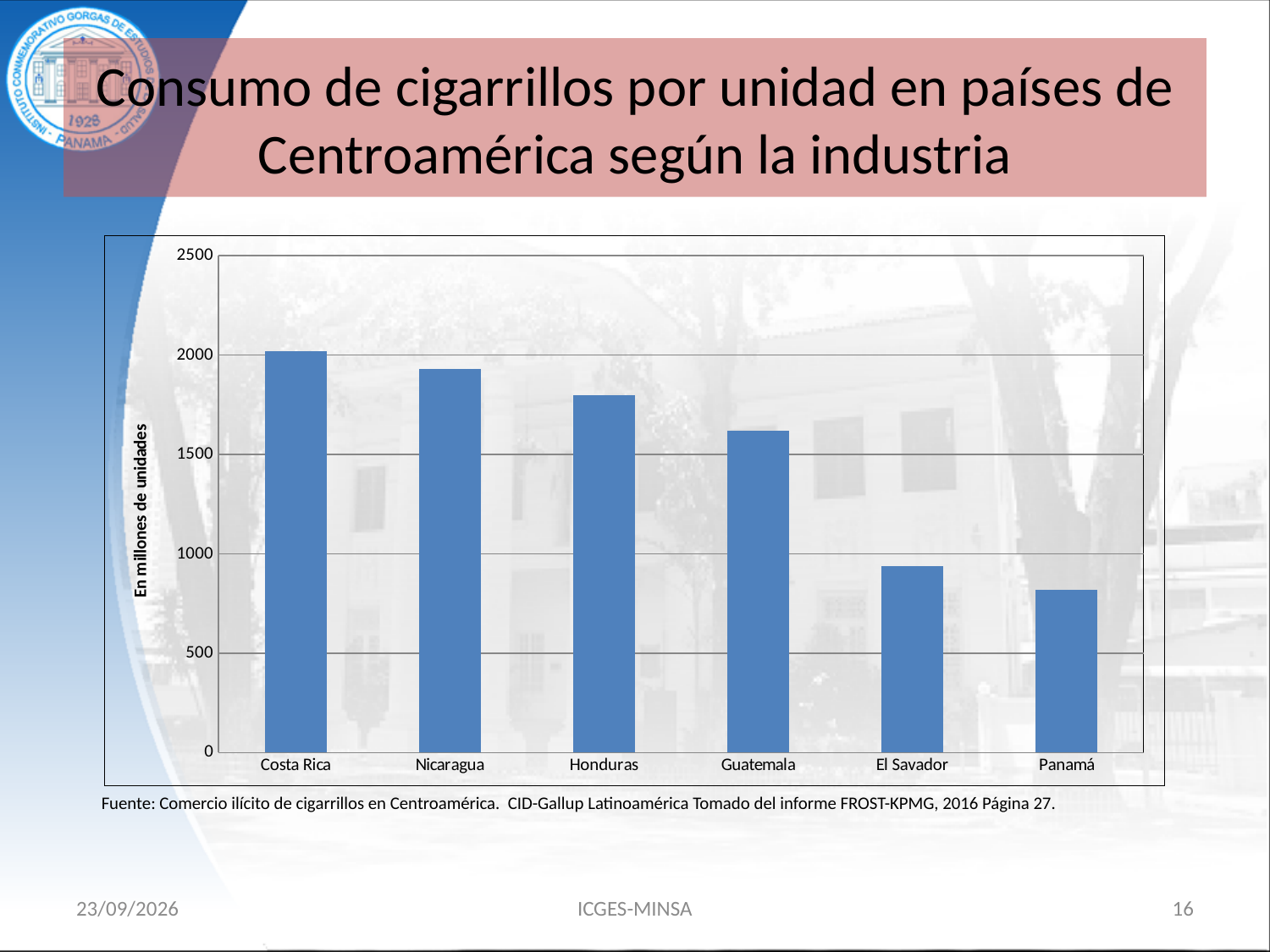
Is the value for El Savador greater or less than 1000? less Is the value for Panamá greater or less than 500? greater Which country has the lowest cigarette consumption in the chart? Panamá Is the value for Nicaragua greater or less than 2000? less How many countries are shown on the x axis of the chart? 6 Which is larger, the value for Guatemala or the value for El Savador? Guatemala What is the label of the vertical axis of the chart? En millones de unidades Do the bar values rise or fall from left to right across the x axis? fall Which country has the highest cigarette consumption in the chart? Costa Rica Which is larger, the value for Honduras or the value for Nicaragua? Nicaragua What kind of chart is shown on the slide? bar chart